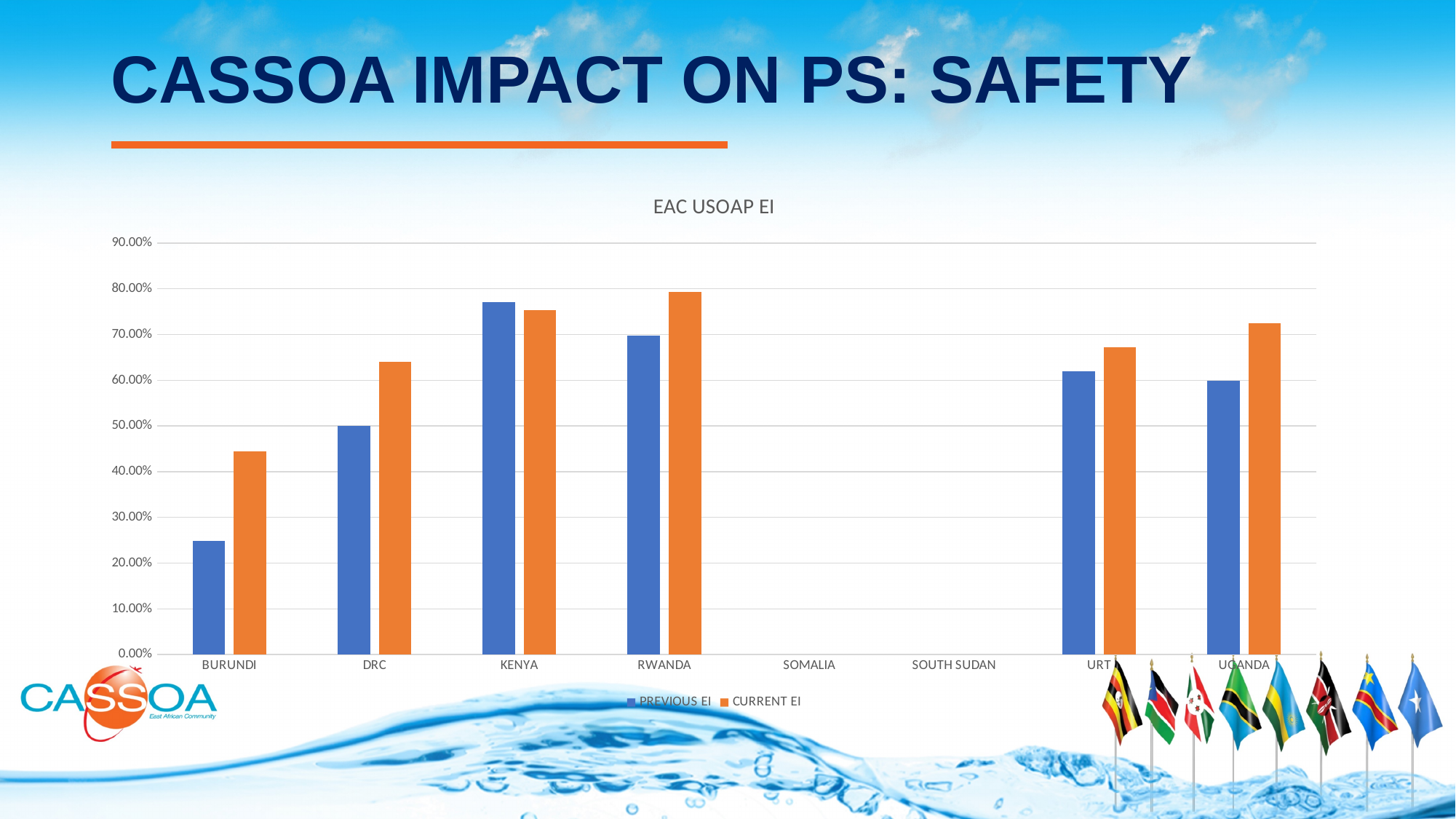
Among the countries with bars shown, which has the lowest PREVIOUS EI value? BURUNDI Which colour represents the CURRENT EI series in the chart? orange For BURUNDI, which is larger: PREVIOUS EI or CURRENT EI? CURRENT EI What kind of chart is shown on the slide? bar chart Is the CURRENT EI value for BURUNDI greater or less than 40.00%? greater Which country has the highest CURRENT EI value? RWANDA How many countries are listed on the x axis of the chart? 8 How many series does the legend list? 2 Is the PREVIOUS EI value for URT greater or less than 70.00%? less Which two countries have no bars plotted in the chart? SOMALIA and SOUTH SUDAN Is the CURRENT EI value for UGANDA greater or less than 70.00%? greater What is the title of the chart? EAC USOAP EI